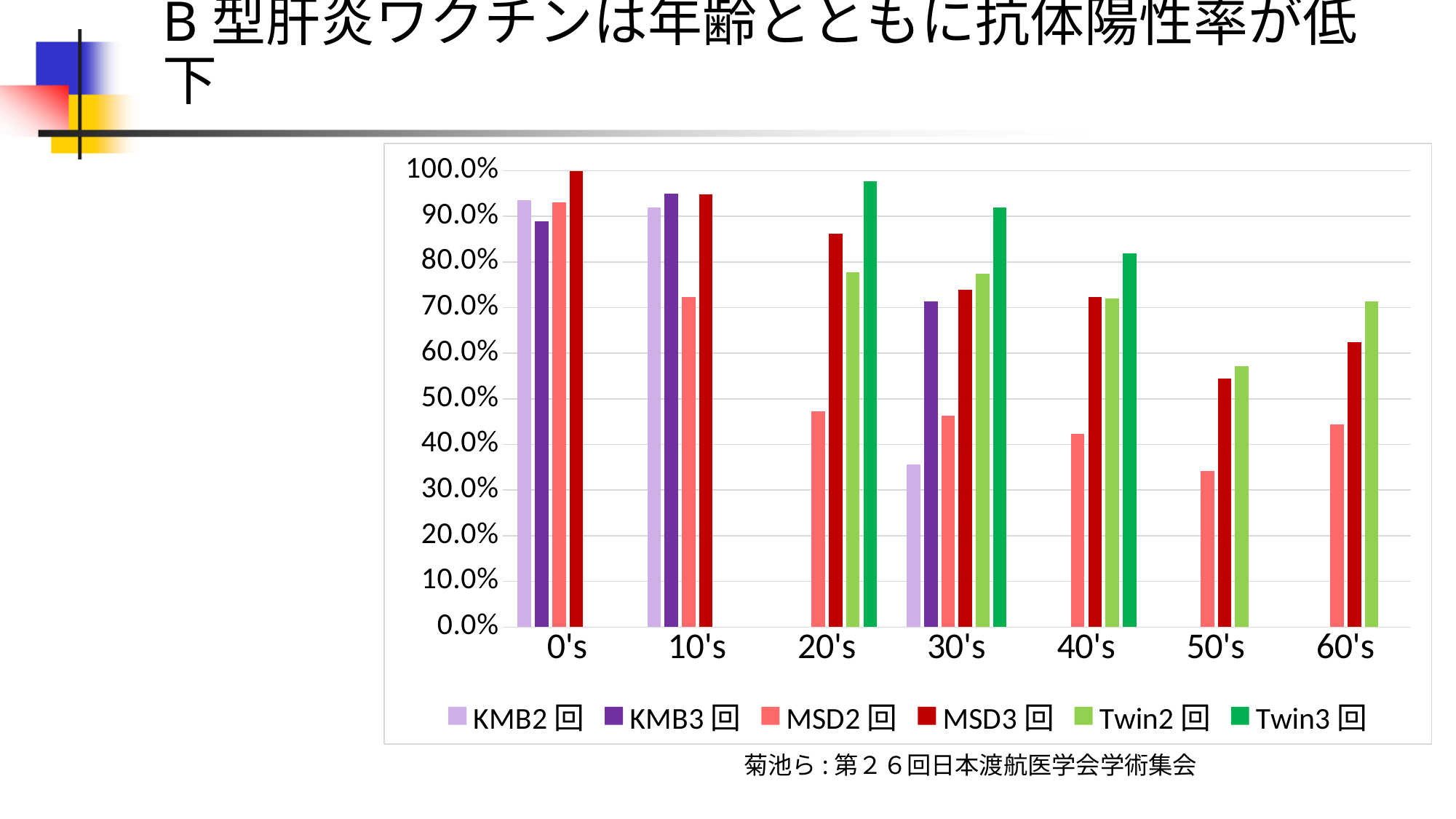
What kind of chart is shown on the slide? bar chart Is the value for Twin3 回 in the 20's category greater or less than 90.0%? greater Is the value for MSD2 回 in the 50's category greater or less than 40.0%? less What colour represents Twin3 回 in the legend? green Is the value for KMB2 回 in the 30's category greater or less than 40.0%? less Does the value for MSD2 回 rise or fall from the 0's category to the 50's category? fall In the 20's category, which is larger, Twin3 回 or MSD2 回? Twin3 回 How many series does the legend list? 6 How many age categories are shown on the x axis? 7 Which series has the lowest value in the 30's category? KMB2 回 Which series has the highest value in the 0's category? MSD3 回 What is the value for MSD3 回 in the 0's category? 100.0%